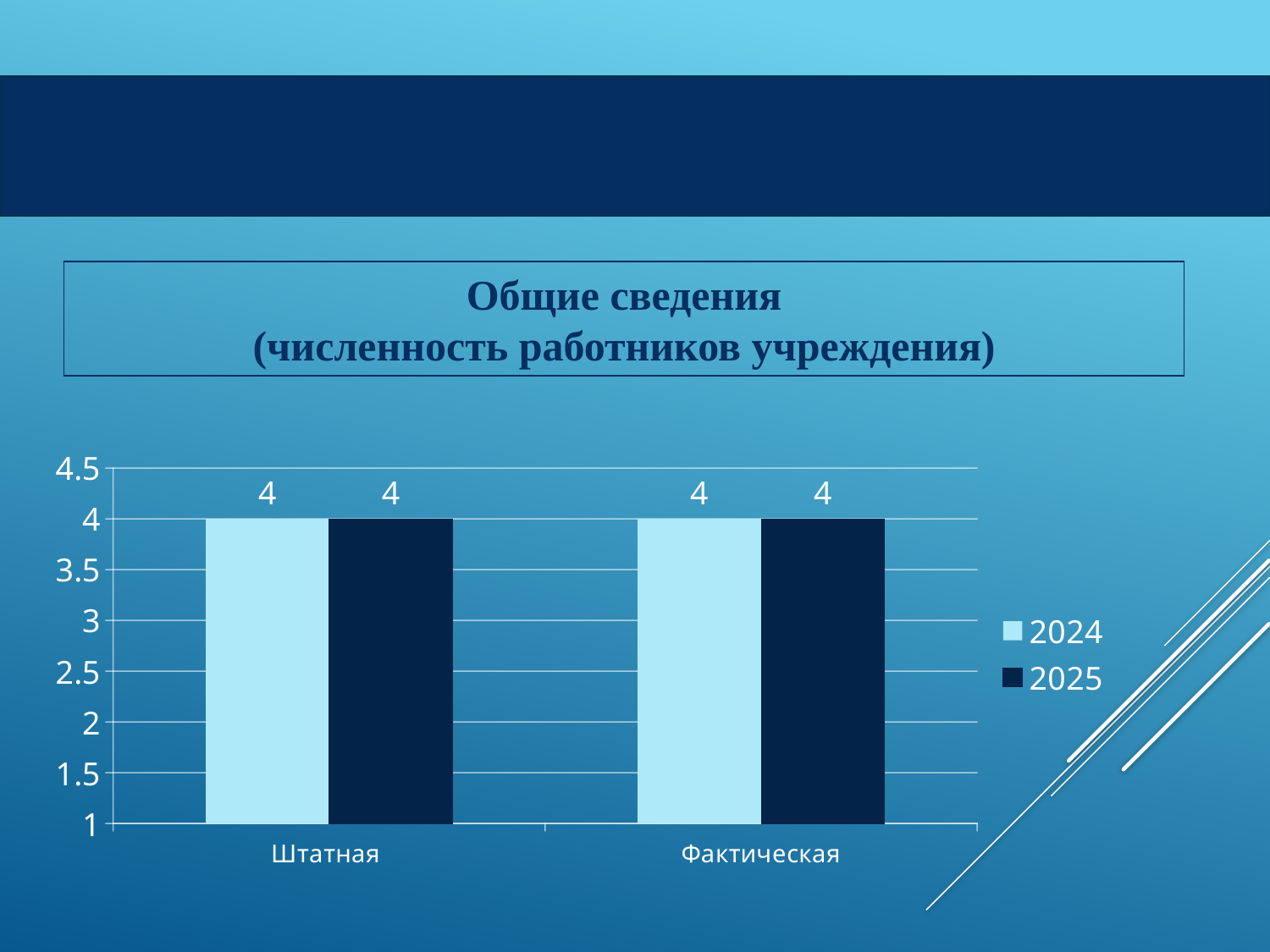
Which series is shown in dark navy in the legend? 2025 How many series does the legend list? 2 What is the value for Фактическая in the 2025 series? 4 What is the value for Штатная in the 2025 series? 4 How many categories are shown on the x axis of the chart? 2 Is the value for Фактическая in the 2024 series greater or less than 3? greater What is the difference between the 2024 and 2025 values for Штатная? 0 What is the title shown above the chart? Общие сведения (численность работников учреждения) What is the difference between the Штатная and Фактическая values in the 2025 series? 0 What kind of chart is shown on the slide? bar chart What is the value for Фактическая in the 2024 series? 4 What is the value for Штатная in the 2024 series? 4